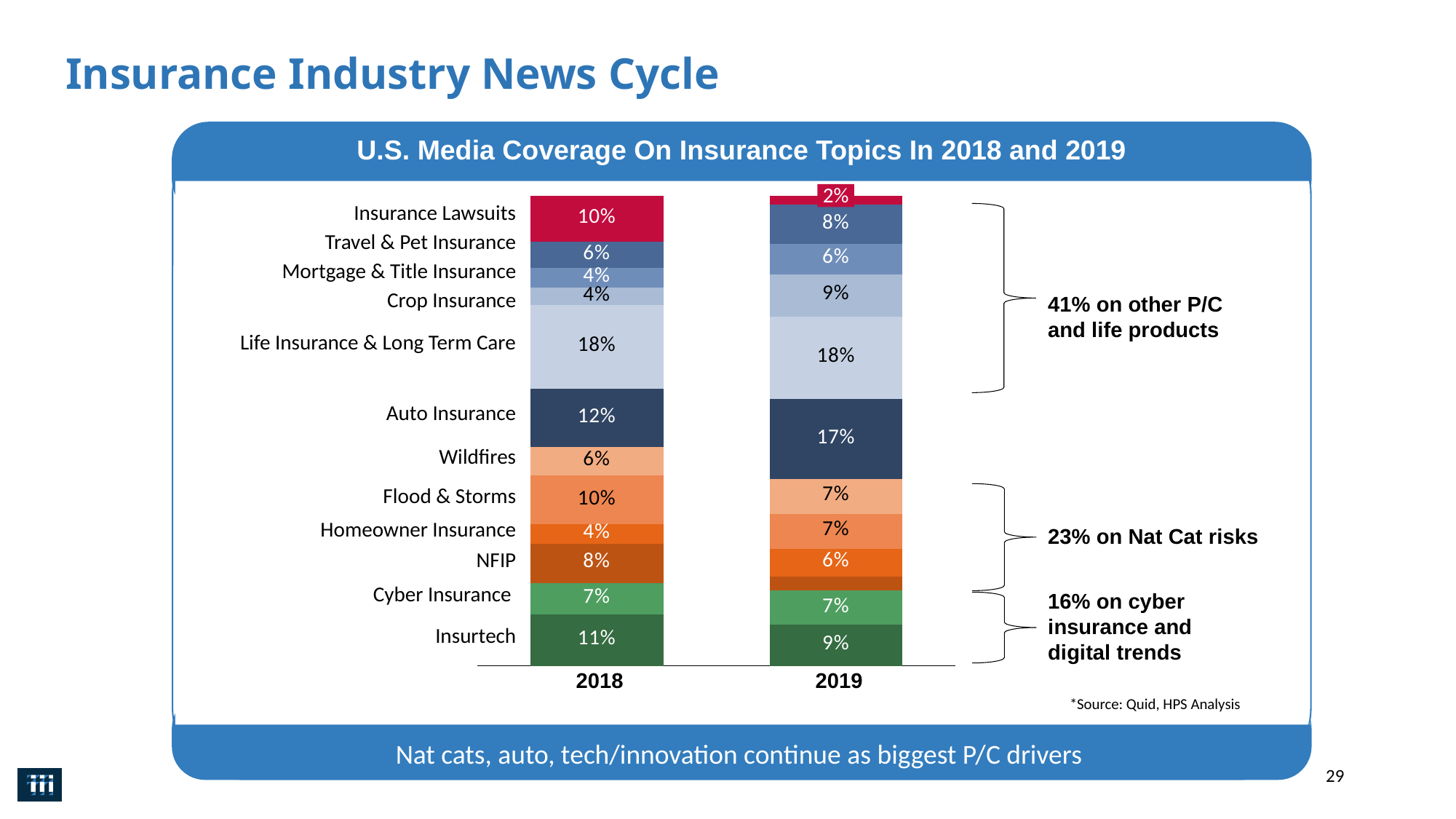
What kind of chart is shown on the slide? Stacked bar chart How many insurance topics are listed along the left side of the chart? 12 According to the annotation on the right, what share of 2019 coverage was on Nat Cat risks? 23% Which topic has the largest segment in the 2018 bar? Life Insurance & Long Term Care What is the value of the top (Insurance Lawsuits) segment in the 2019 bar? 2% What is the value for Insurtech in the 2018 bar? 11% How many stacked bars are shown in the chart? 2 What is the title of the chart? U.S. Media Coverage On Insurance Topics In 2018 and 2019 What share of 2018 media coverage went to Life Insurance & Long Term Care? 18% By how many percentage points did Auto Insurance coverage change from 2018 (12%) to 2019 (17%)? 5 percentage points What is the value for Auto Insurance in the 2019 bar? 17% In 2018, which had a larger share: Flood & Storms or NFIP? Flood & Storms